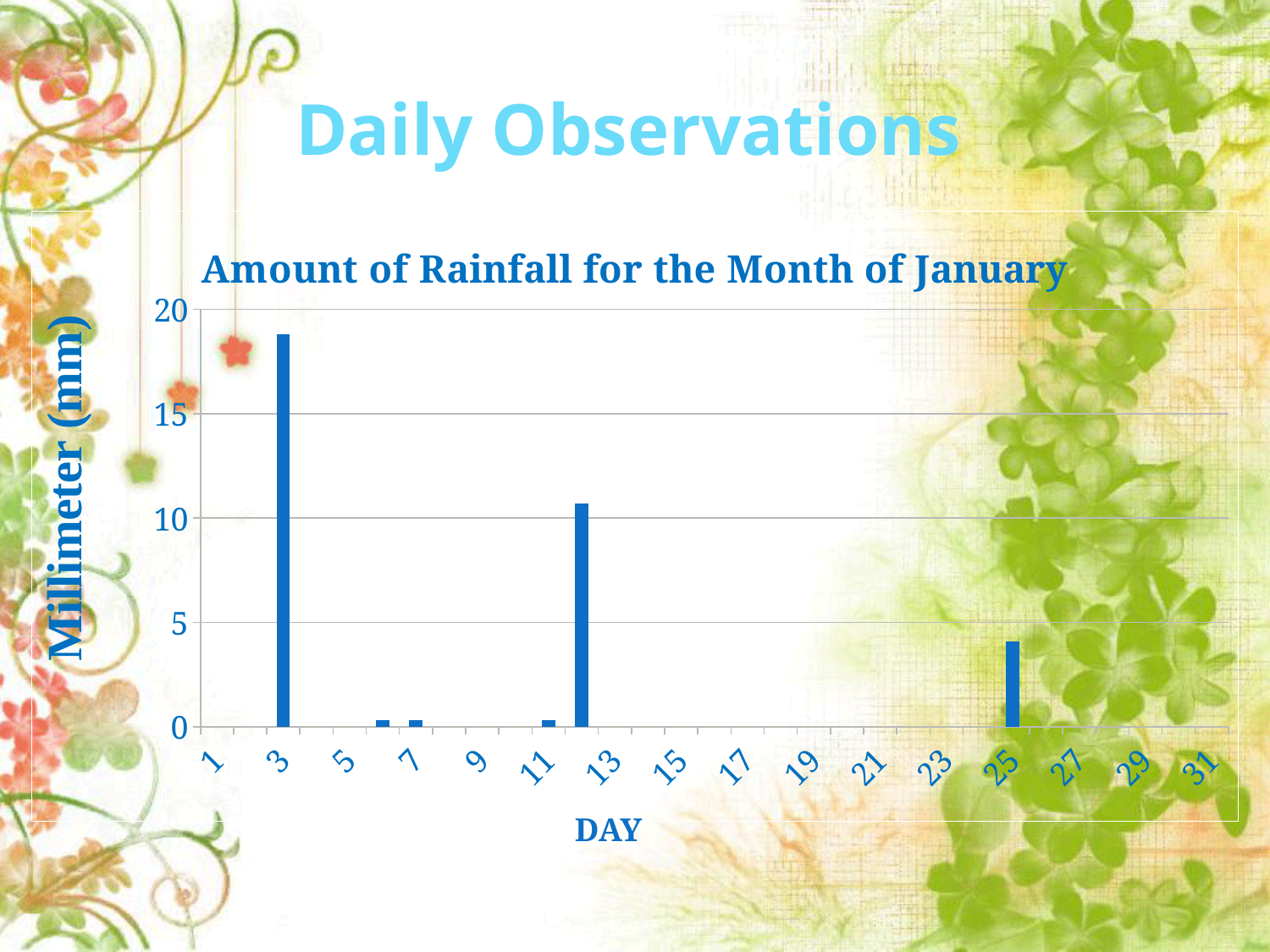
Is the rainfall value for day 12 greater or less than 15? less What kind of chart is shown on the slide? bar chart What is the highest value shown on the vertical axis of the chart? 20 Which day has more rainfall, day 12 or day 25? 12 Which day has more rainfall, day 3 or day 12? 3 What is the title of the chart? Amount of Rainfall for the Month of January Is the rainfall value for day 25 greater or less than 5? less What is the label of the vertical axis of the chart? Millimeter (mm) How many days in the chart have rainfall above 5 mm? 2 Is the rainfall value for day 3 greater or less than 15? greater Which day has the highest amount of rainfall in the chart? 3